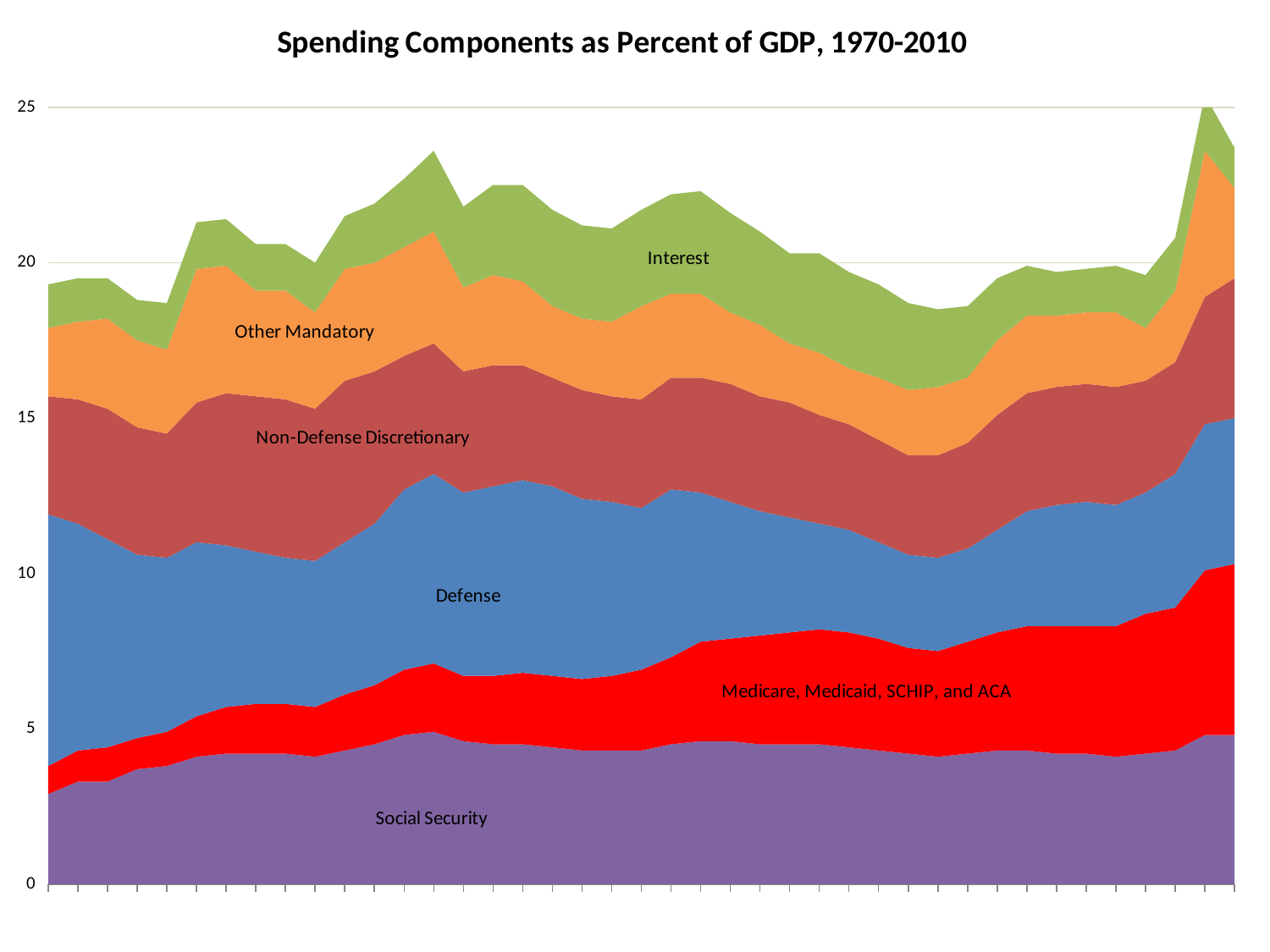
How many spending components (series) are labeled in the chart? 6 What kind of chart is shown on the slide? Stacked area chart Does the Defense band get thicker or thinner from the left edge to the right edge of the chart? thinner Does the Social Security band rise or fall from the left edge to the right edge of the chart? rises Is the total spending as percent of GDP at the left edge of the chart (1970) greater or less than 20? less Does the Medicare, Medicaid, SCHIP, and ACA band get thicker or thinner from the left edge to the right edge of the chart? thicker What is the title of the chart? Spending Components as Percent of GDP, 1970-2010 Is the total spending as percent of GDP at the highest peak near the right edge of the chart greater or less than 20? greater Which spending component forms the bottom layer of the stacked area chart? Social Security Is the total spending as percent of GDP at the right edge of the chart (2010) greater or less than 20? greater